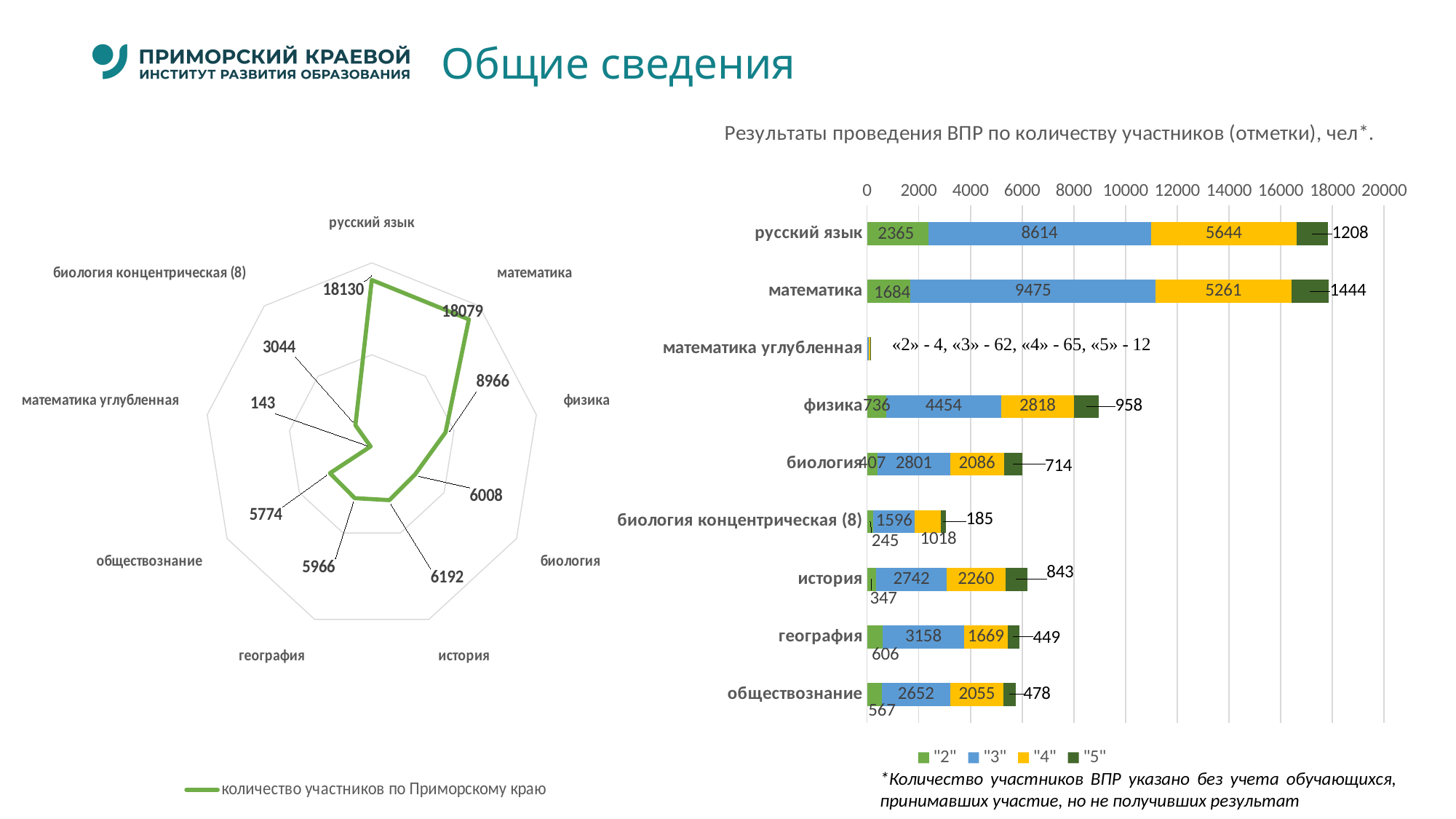
In the bar chart on the right, how many series does the legend list? 4 What type of chart is shown on the right side of the slide? stacked bar chart In the bar chart on the right, what is the value of the "4" series for география? 1669 In the bar chart on the right, what is the value of the "3" series for математика? 9475 On the radar chart on the left, how many subjects are plotted? 9 On the radar chart on the left, what is the value for русский язык? 18130 On the radar chart on the left, which is larger: the value for физика or the value for биология? физика In the bar chart on the right, which subject has the highest value in the "5" series? математика On the radar chart on the left, what is the difference between the values for история and география? 226 In the bar chart on the right, what is the total of the stacked bar for русский язык? 17831 In the bar chart on the right, what is the value of the "5" series for физика? 958 On the radar chart on the left, which subject has the lowest number of participants? математика углубленная